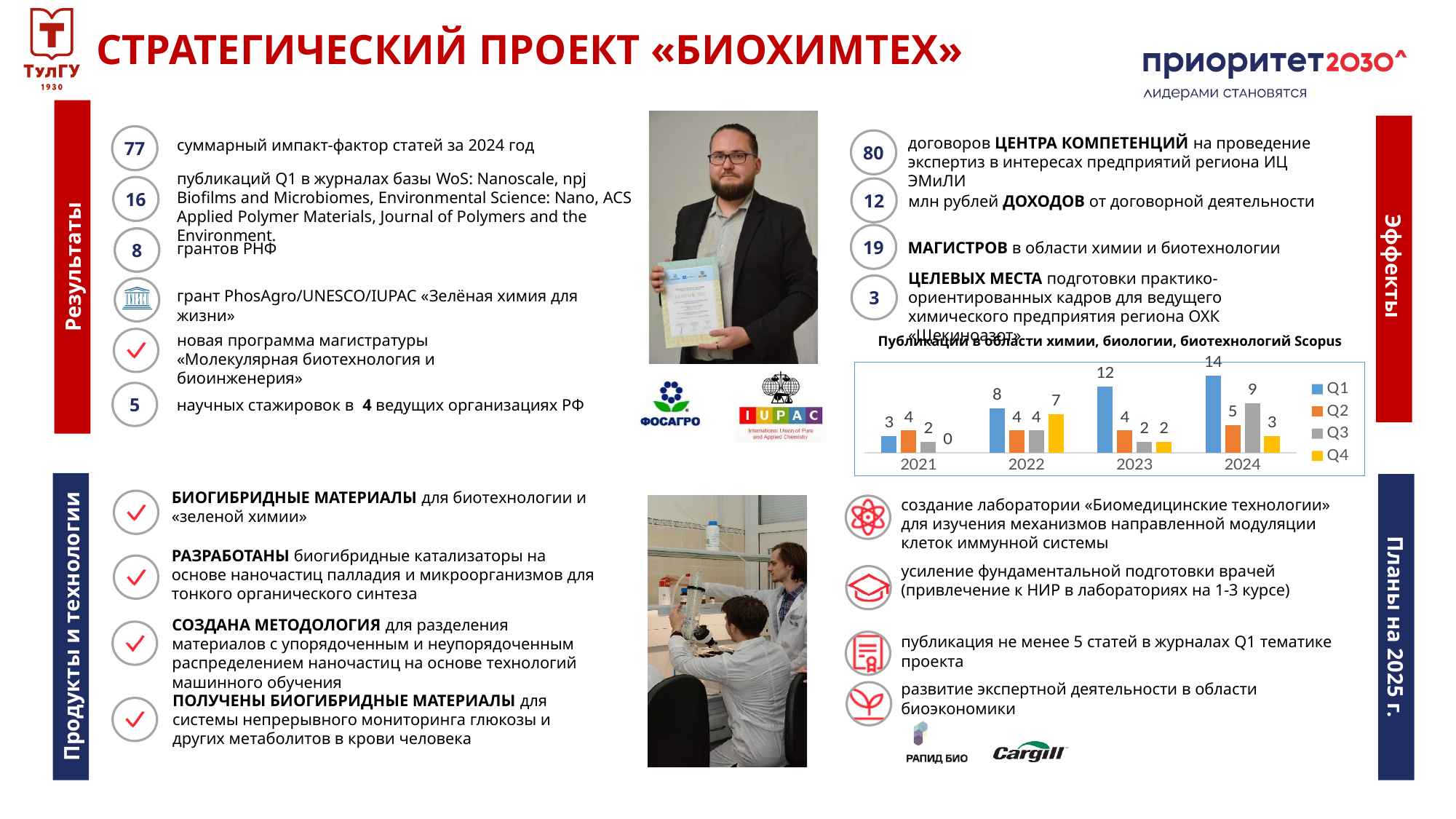
Does the Q1 value rise or fall from 2021 to 2024? rise What is the Q4 value for 2022 in the chart? 7 What is the Q1 value for 2024 in the chart? 14 How many series does the chart legend list? 4 What is the difference between the Q1 values for 2024 and 2021? 11 Which is larger in 2024: the Q3 value or the Q2 value? Q3 What kind of chart is shown on the slide? bar chart What is the title of the chart? Публикации в области химии, биологии, биотехнологий Scopus In which year is the Q4 value lowest? 2021 What is the Q3 value for 2021 in the chart? 2 In which year is the Q1 value highest? 2024 How many years are shown on the x axis of the chart? 4